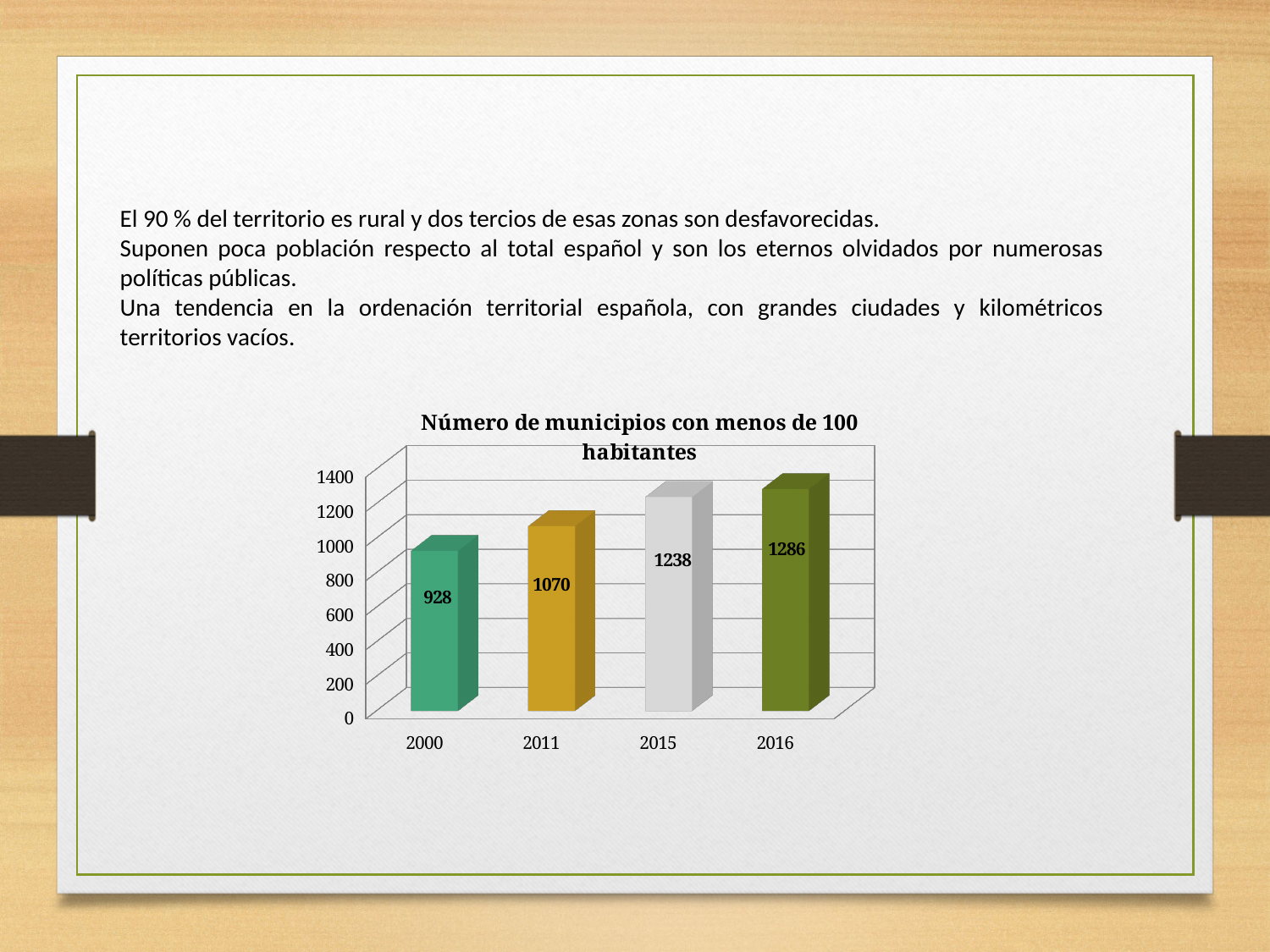
What value is shown for 2016? 1286 What is the difference between the values for 2015 and 2011? 168 Which year has the highest value? 2016 What value is shown for 2015? 1238 Which year has the lowest value? 2000 What value is shown for 2011? 1070 Which is larger, the value for 2011 or the value for 2015? 2015 How many years are shown on the x axis? 4 What is the difference between the values for 2016 and 2000? 358 Do the values rise or fall from 2000 to 2016? Rise What is the number of municipalities with fewer than 100 inhabitants in 2000? 928 What kind of chart is this? Bar chart